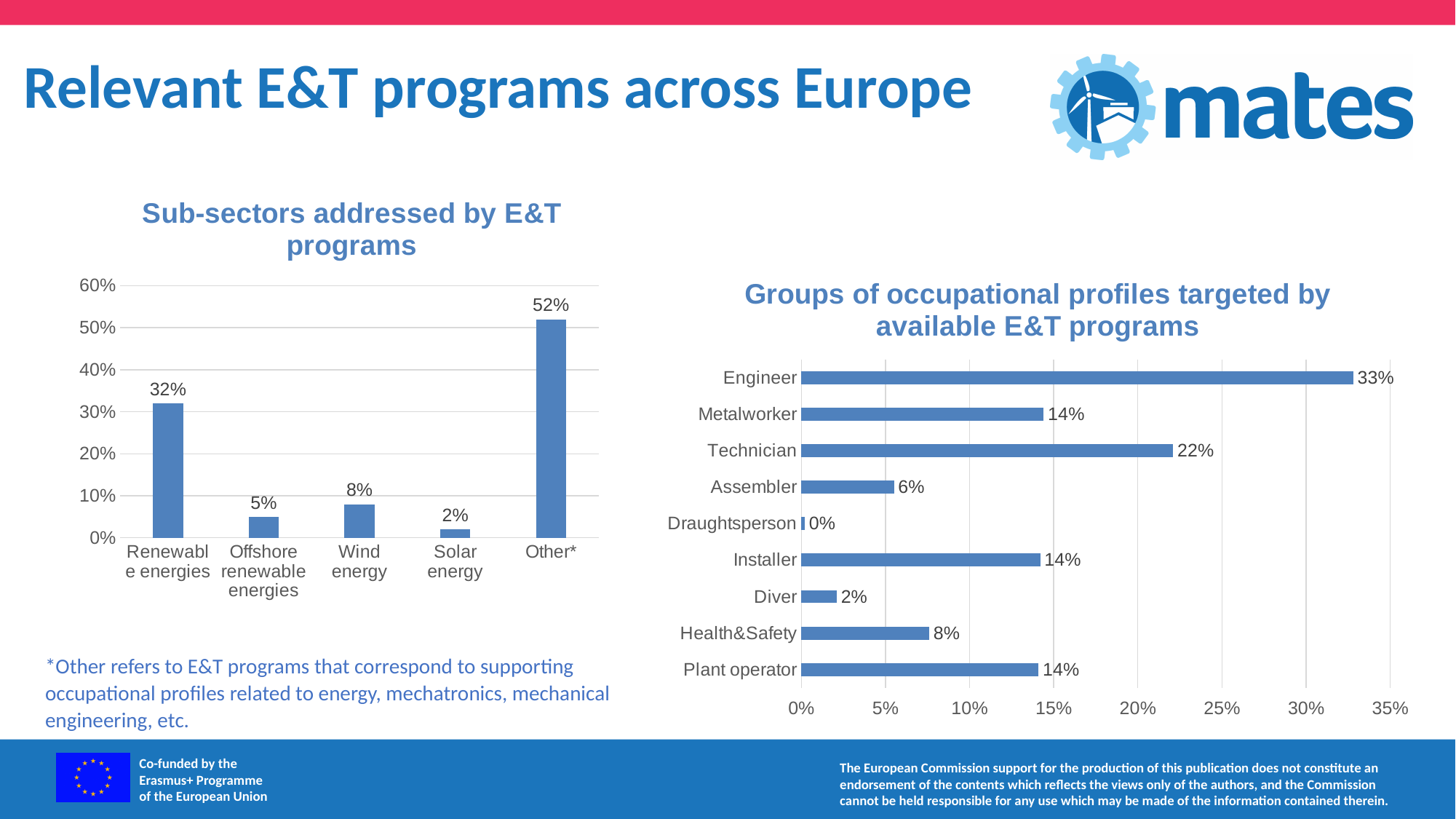
In the 'Groups of occupational profiles targeted by available E&T programs' chart, how many occupational groups are listed? 9 In the 'Groups of occupational profiles targeted by available E&T programs' chart, what is the difference between Engineer and Metalworker? 19% In the 'Sub-sectors addressed by E&T programs' chart, which category has the lowest value? Solar energy In the 'Groups of occupational profiles targeted by available E&T programs' chart, which group has the lowest value? Draughtsperson In the 'Sub-sectors addressed by E&T programs' chart, what is the difference between Other* and Renewable energies? 20% What kind of chart is 'Groups of occupational profiles targeted by available E&T programs'? Bar chart In the 'Sub-sectors addressed by E&T programs' chart, which category has the highest value? Other* In the 'Groups of occupational profiles targeted by available E&T programs' chart, which group has the highest value? Engineer In the 'Groups of occupational profiles targeted by available E&T programs' chart, what is the value for Technician? 22% In the 'Groups of occupational profiles targeted by available E&T programs' chart, which is larger: Assembler or Health&Safety? Health&Safety In the 'Sub-sectors addressed by E&T programs' chart, how many categories are shown? 5 In the 'Sub-sectors addressed by E&T programs' chart, what is the value for Wind energy? 8%